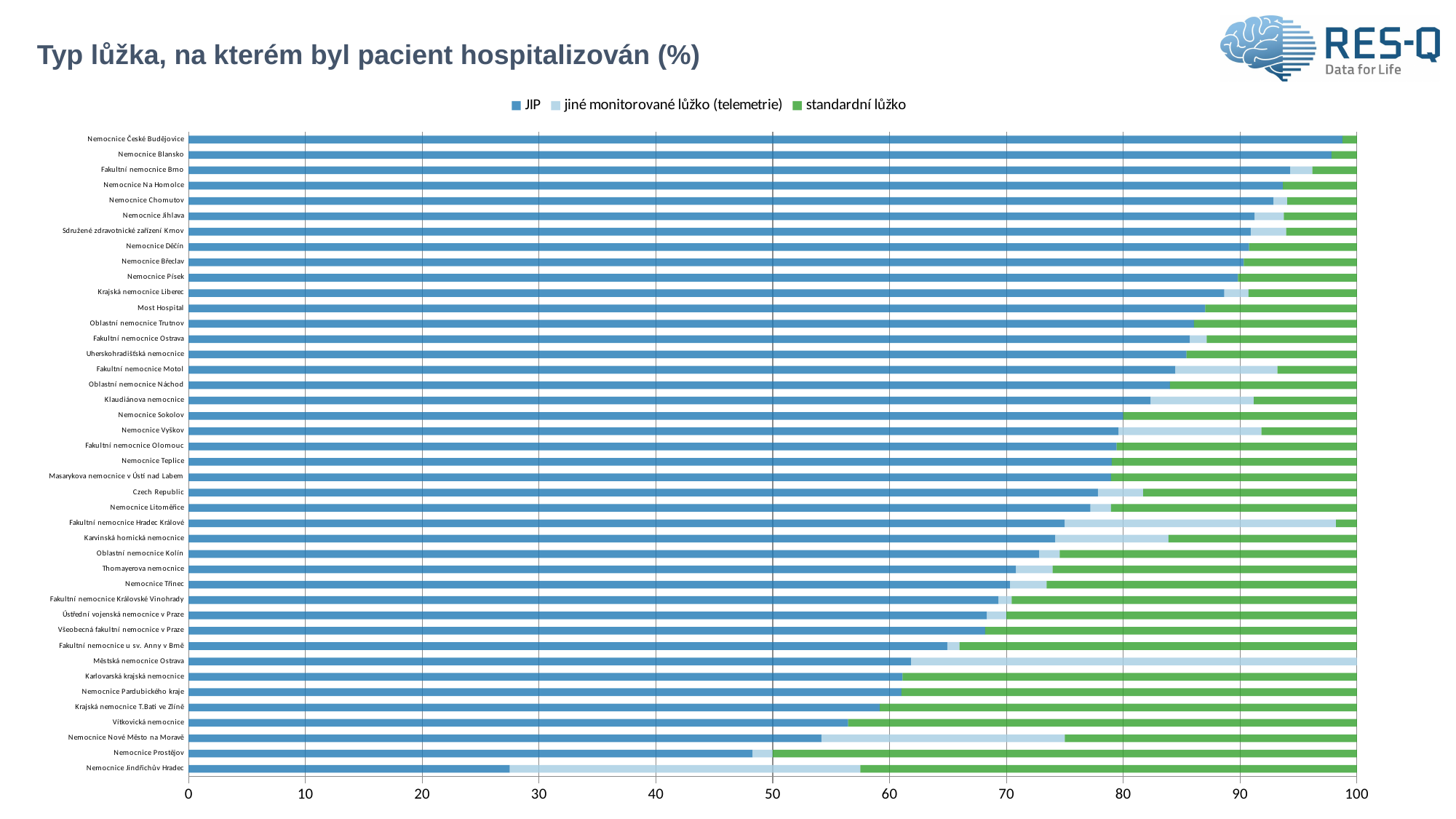
How many series does the legend list? 3 Which hospital has the largest 'jiné monitorované lůžko (telemetrie)' segment? Městská nemocnice Ostrava Is the JIP value for Nemocnice Jindřichův Hradec greater or less than 30? less What is the title of the chart? Typ lůžka, na kterém byl pacient hospitalizován (%) Which hospital has the lowest JIP share? Nemocnice Jindřichův Hradec Which is larger, the JIP share for Nemocnice Blansko or for Nemocnice Prostějov? Nemocnice Blansko Which hospital has the highest JIP share? Nemocnice České Budějovice Is the JIP value for Nemocnice České Budějovice greater or less than 90? greater Going from the top of the chart to the bottom, do the JIP values rise or fall? fall How many hospitals (categories) are plotted on the chart? 42 Is the JIP value for Nemocnice Prostějov greater or less than 50? less What kind of chart is shown on the slide? Stacked horizontal bar chart